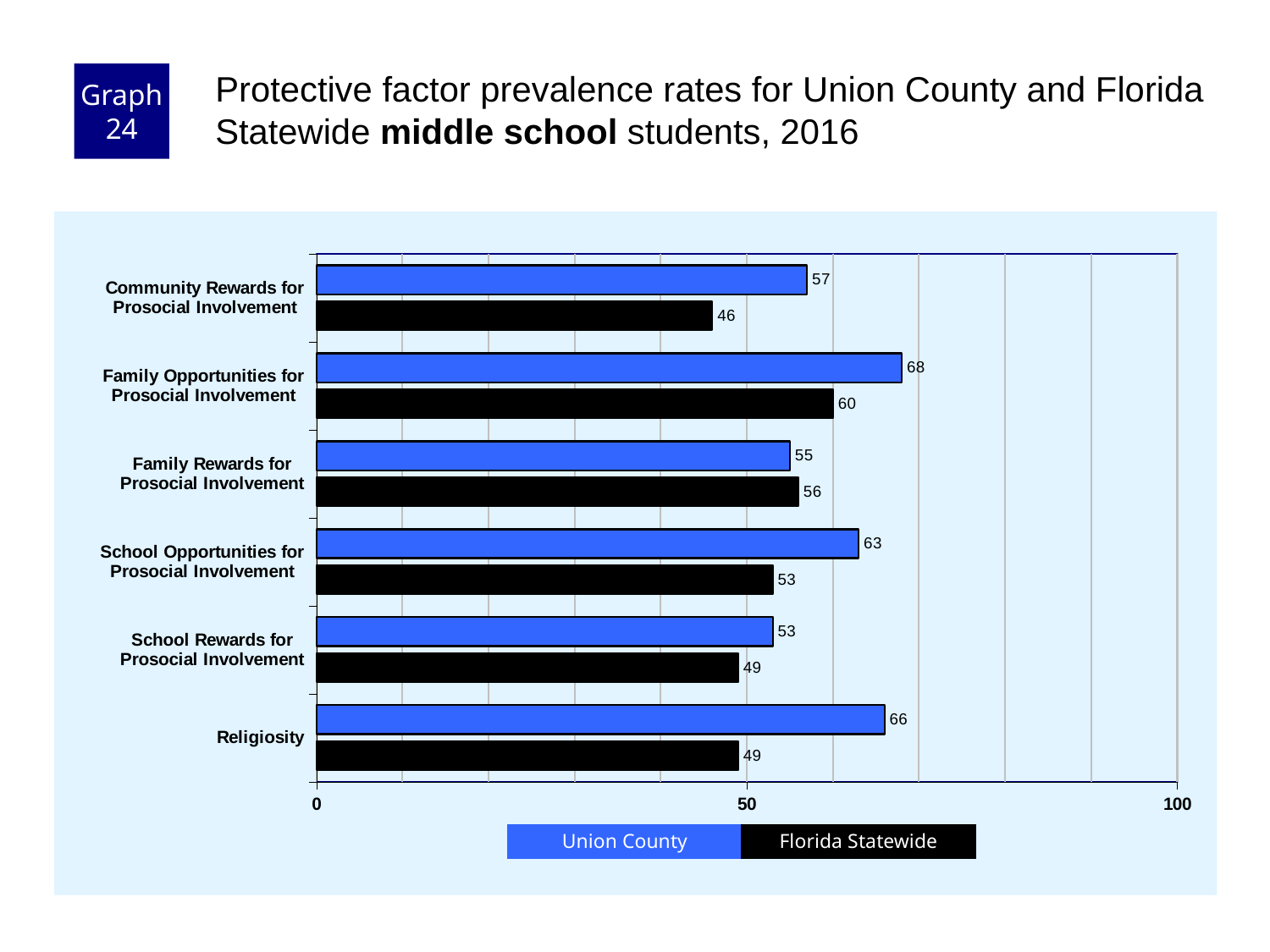
What is the Florida Statewide value for Community Rewards for Prosocial Involvement? 46 What is the difference between the Union County and Florida Statewide values for Religiosity? 17 Which category has the lowest Florida Statewide value? Community Rewards for Prosocial Involvement What is the difference between the Union County and Florida Statewide values for Community Rewards for Prosocial Involvement? 11 For School Opportunities for Prosocial Involvement, which is larger: the Union County value or the Florida Statewide value? Union County Is the Florida Statewide value for Family Opportunities for Prosocial Involvement greater or less than 50? greater How many series does the legend list? 2 Which category has the highest Union County value? Family Opportunities for Prosocial Involvement What kind of chart is shown on the slide? Bar chart What is the Union County value for Family Opportunities for Prosocial Involvement? 68 How many categories are shown on the chart? 6 What is the Florida Statewide value for Religiosity? 49